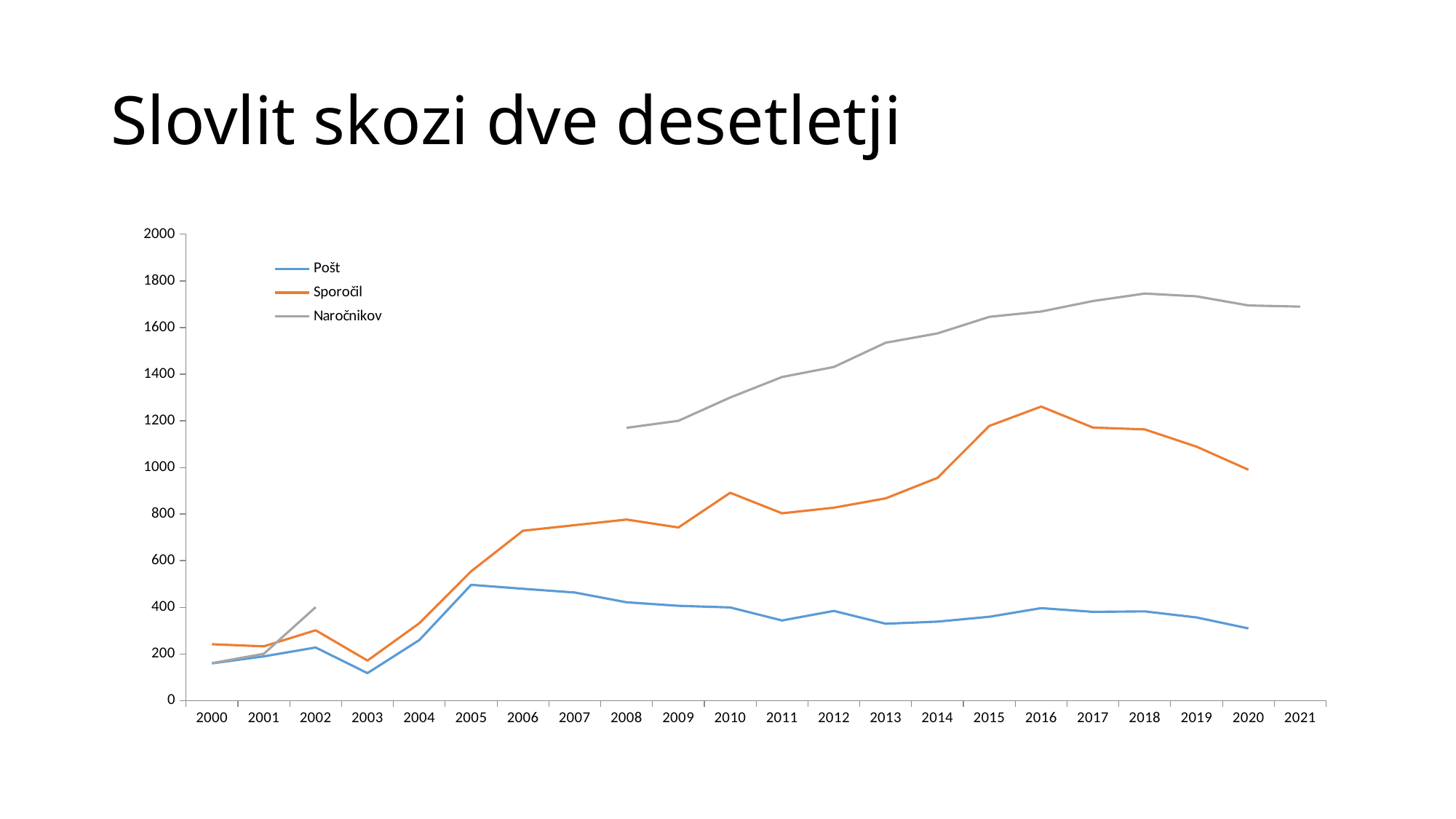
In which year does the Sporočil series reach its highest value? 2016 What kind of chart is shown on the slide? line chart In which year does the Sporočil series reach its lowest value? 2003 What colour is the line for the Naročnikov series? grey Which series has the higher value in 2015, Naročnikov or Sporočil? Naročnikov Is the value for Sporočil in 2016 greater or less than 1200? greater Is the value for Naročnikov in 2020 greater or less than 1600? greater How many years are shown on the x axis? 22 Does the Naročnikov series rise or fall from 2008 to 2018? rise How many series does the legend list? 3 In which year does the Pošt series reach its lowest value? 2003 Is the value for Pošt in 2020 greater or less than 400? less